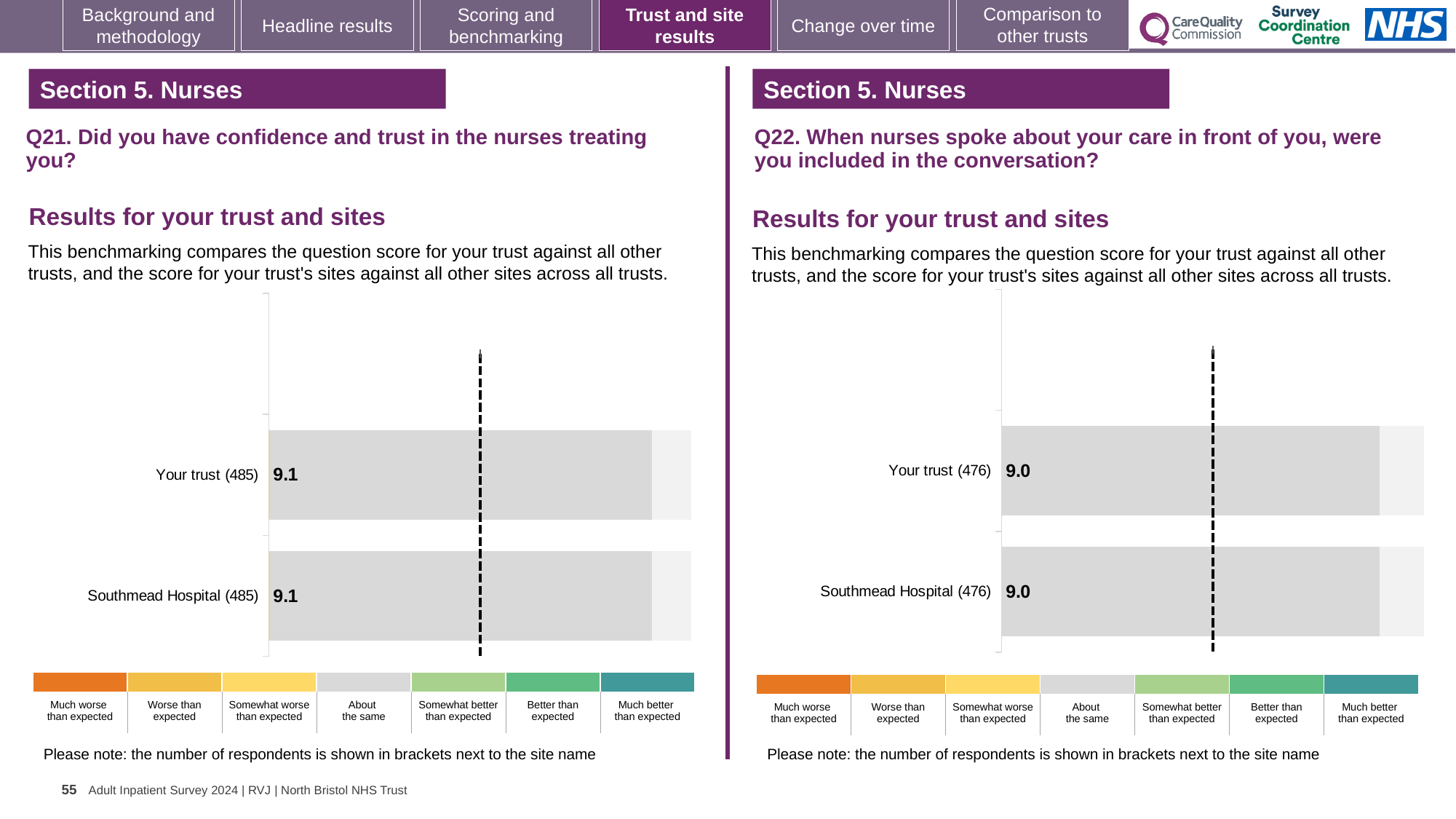
On the Q22 chart (right), what is the score for Southmead Hospital? 9.0 On the Q21 chart (left), how many respondents are shown in brackets next to Your trust? 485 On the Q22 chart (right), what is the score for Your trust? 9.0 On the Q22 chart (right), how many bars are plotted? 2 On the Q21 chart (left), what is the difference between the score for Your trust and the score for Southmead Hospital? 0.0 What kind of chart is the Q21 chart (left)? Bar chart On the Q21 chart (left), what is the score for Southmead Hospital? 9.1 On the Q21 chart (left), how many bars are plotted? 2 On the Q22 chart (right), what is the difference between the score for Your trust and the score for Southmead Hospital? 0.0 On the Q22 chart (right), how many respondents are shown in brackets next to Southmead Hospital? 476 On the Q21 chart (left), what is the score for Your trust? 9.1